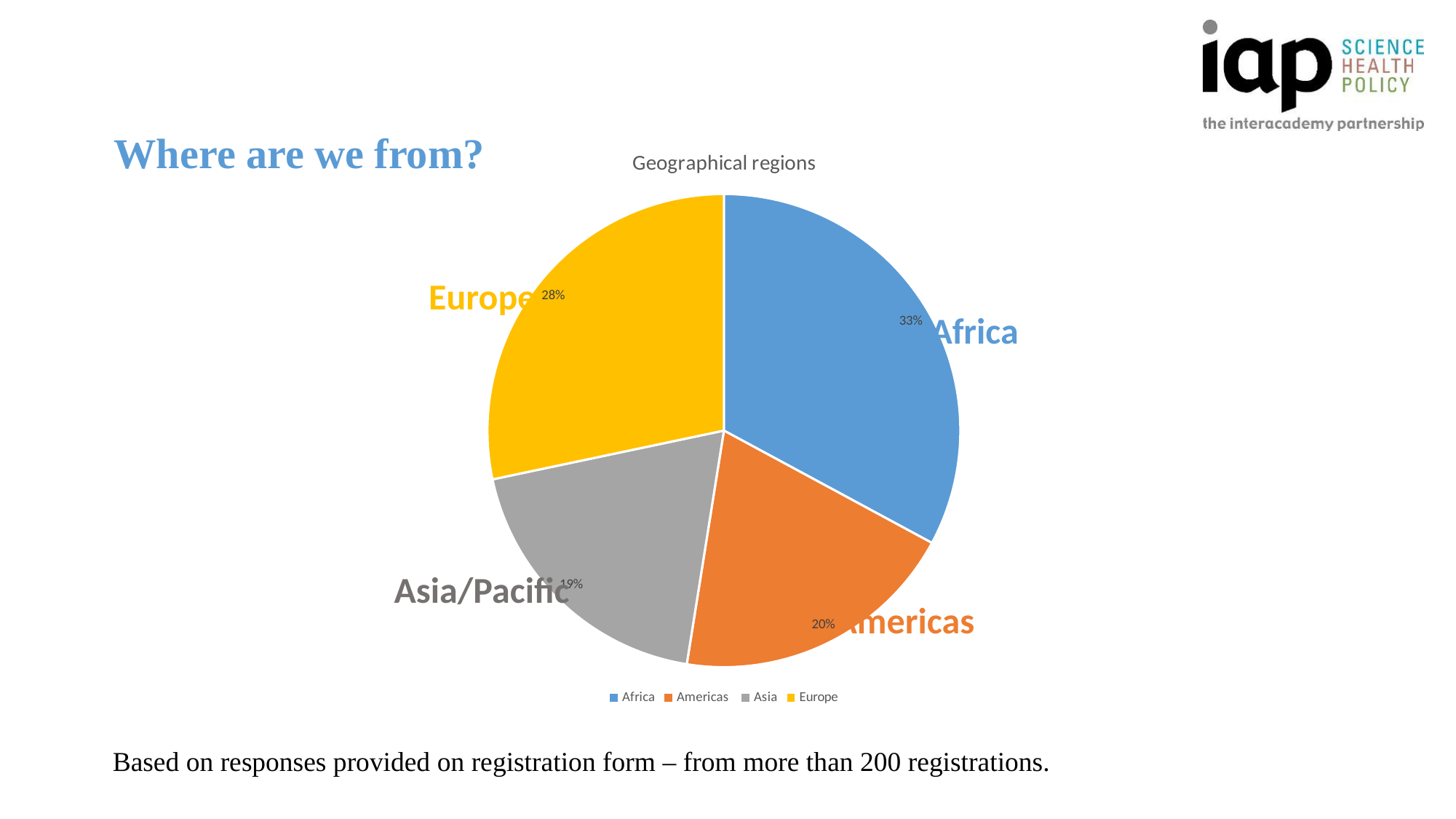
What colour is the Europe slice? yellow Which region has the largest share of the pie? Africa What is the title of the chart? Geographical regions How many slices does the pie chart have? 4 What is the difference in percentage points between Africa's share and Europe's share? 5 What percentage of the pie does Europe account for? 28% Which has a larger share, Europe or Americas? Europe Which region has the smallest share of the pie? Asia What percentage of the pie does Asia account for? 19% What kind of chart is shown on the slide? pie chart What percentage of the pie does Africa account for? 33% What percentage of the pie does Americas account for? 20%